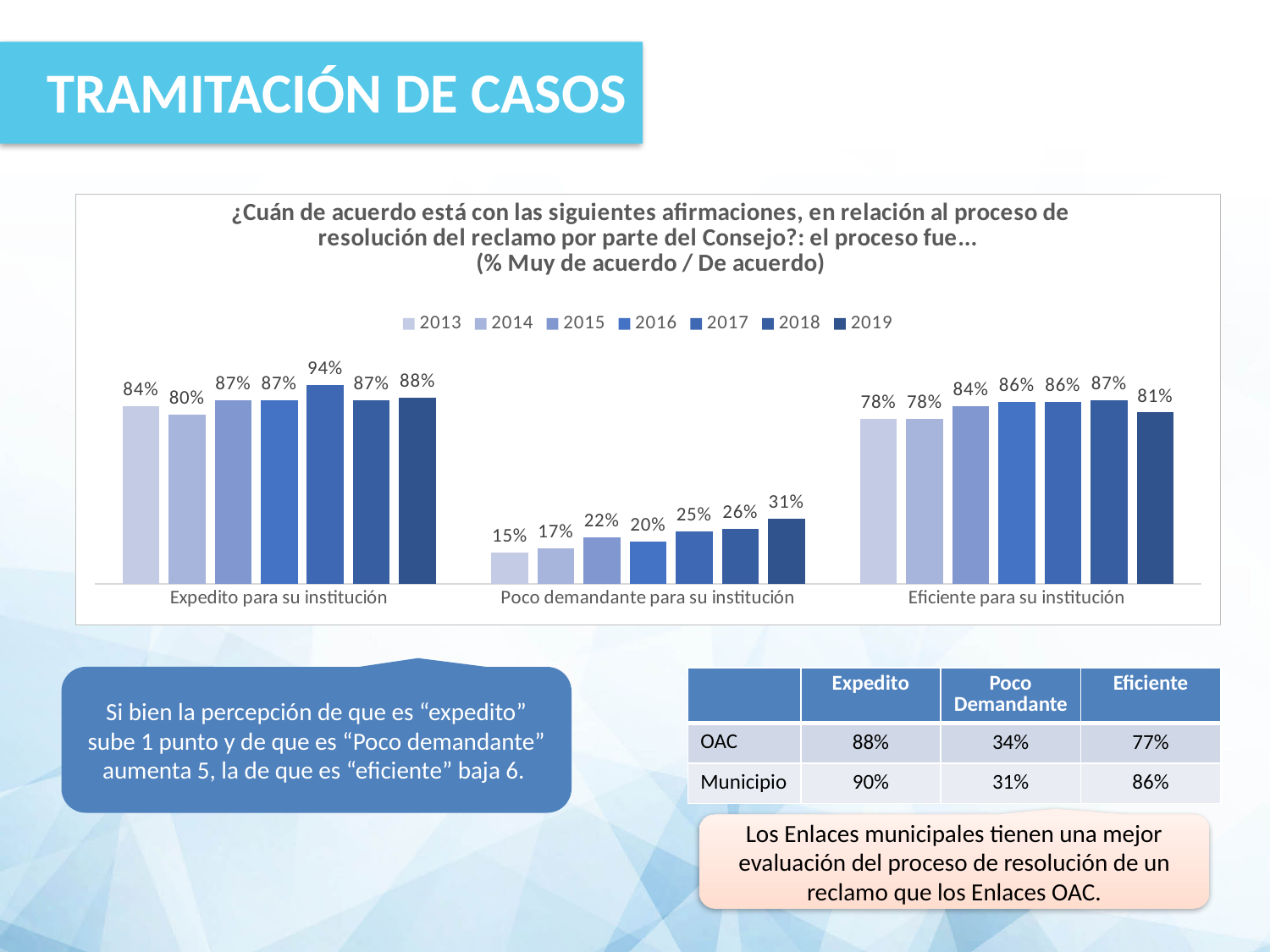
Which year has the highest value in the category "Expedito para su institución"? 2017 What is the value for 2018 in the category "Eficiente para su institución"? 87% How many categories are shown on the x axis of the chart? 3 What is the value for 2013 in the category "Poco demandante para su institución"? 15% Which year is shown in the darkest blue in the chart legend? 2019 What is the difference between the 2019 and 2018 values in the category "Eficiente para su institución"? 6% What type of chart is shown on the slide? Bar chart Which is larger: the 2019 value for "Expedito para su institución" or the 2019 value for "Eficiente para su institución"? Expedito para su institución Do the values for "Poco demandante para su institución" generally rise or fall from 2013 to 2019? Rise Which year has the lowest value in the category "Poco demandante para su institución"? 2013 How many series does the chart legend list? 7 What is the value for 2019 in the category "Expedito para su institución"? 88%